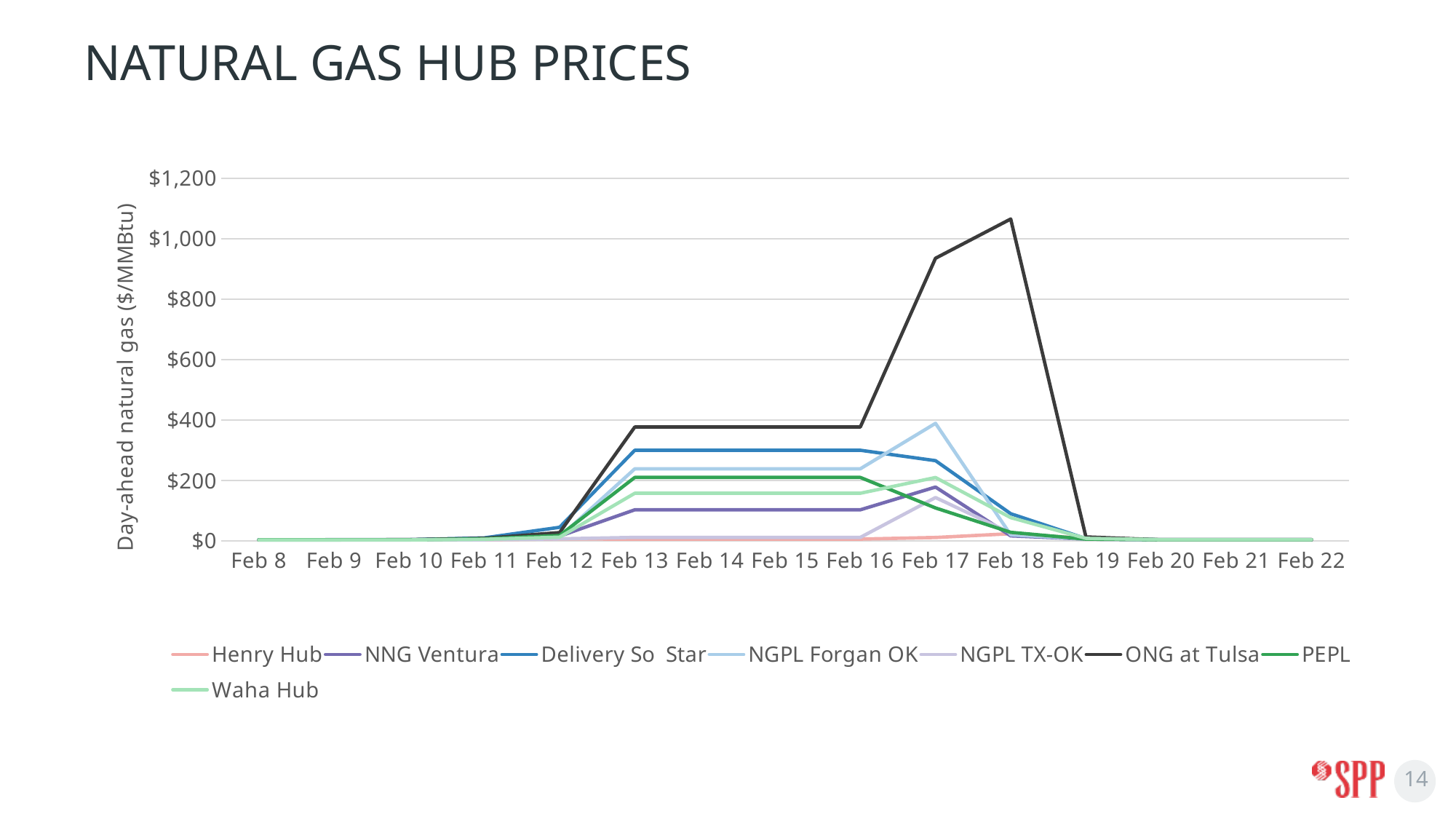
What kind of chart is shown on the slide? line chart What is the label on the y axis? Day-ahead natural gas ($/MMBtu) How many series does the legend list? 8 Which series reaches the highest price on the chart? ONG at Tulsa Does the ONG at Tulsa price rise or fall from Feb 18 to Feb 19? fall On Feb 17, which is higher: ONG at Tulsa or NGPL Forgan OK? ONG at Tulsa Is the value for NGPL Forgan OK on Feb 17 greater or less than $200? greater Is the value for ONG at Tulsa on Feb 18 greater or less than $1,000? greater Is the value for ONG at Tulsa on Feb 17 greater or less than $800? greater On which date does the ONG at Tulsa price reach its peak? Feb 18 How many dates are shown along the x axis? 15